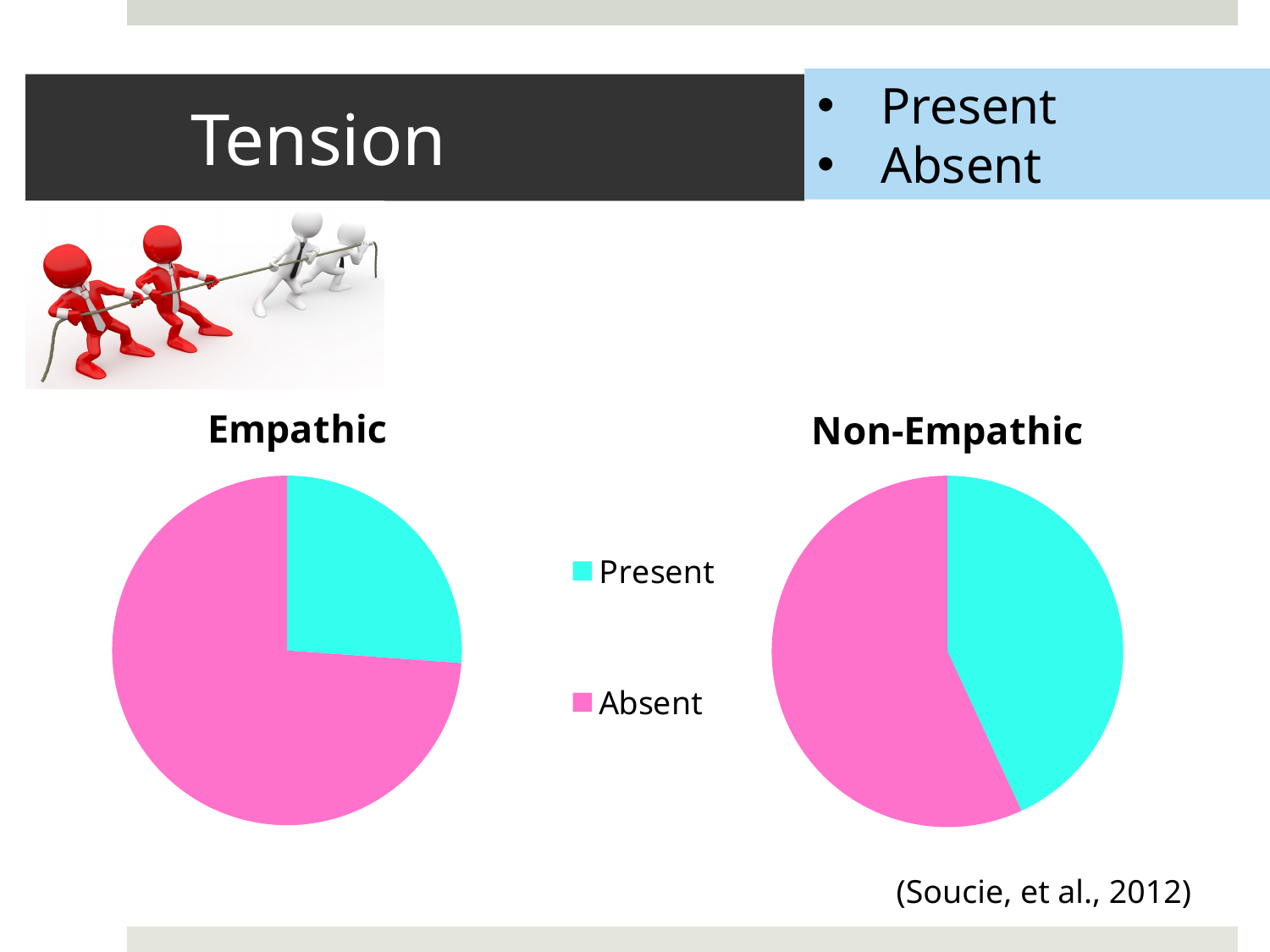
What is the title of the pie chart on the right? Non-Empathic Is the Absent slice larger in the Empathic chart or the Non-Empathic chart? Empathic In the Empathic pie chart, which slice is the largest? Absent What colour represents Present in the pie charts? cyan Is the Present slice larger in the Empathic chart or the Non-Empathic chart? Non-Empathic In the Empathic pie chart, which slice is the smallest? Present What kind of chart is the Non-Empathic chart? pie chart What kind of chart is the Empathic chart? pie chart How many slices does the Empathic pie chart have? 2 How many entries does the legend list? 2 How many slices does the Non-Empathic pie chart have? 2